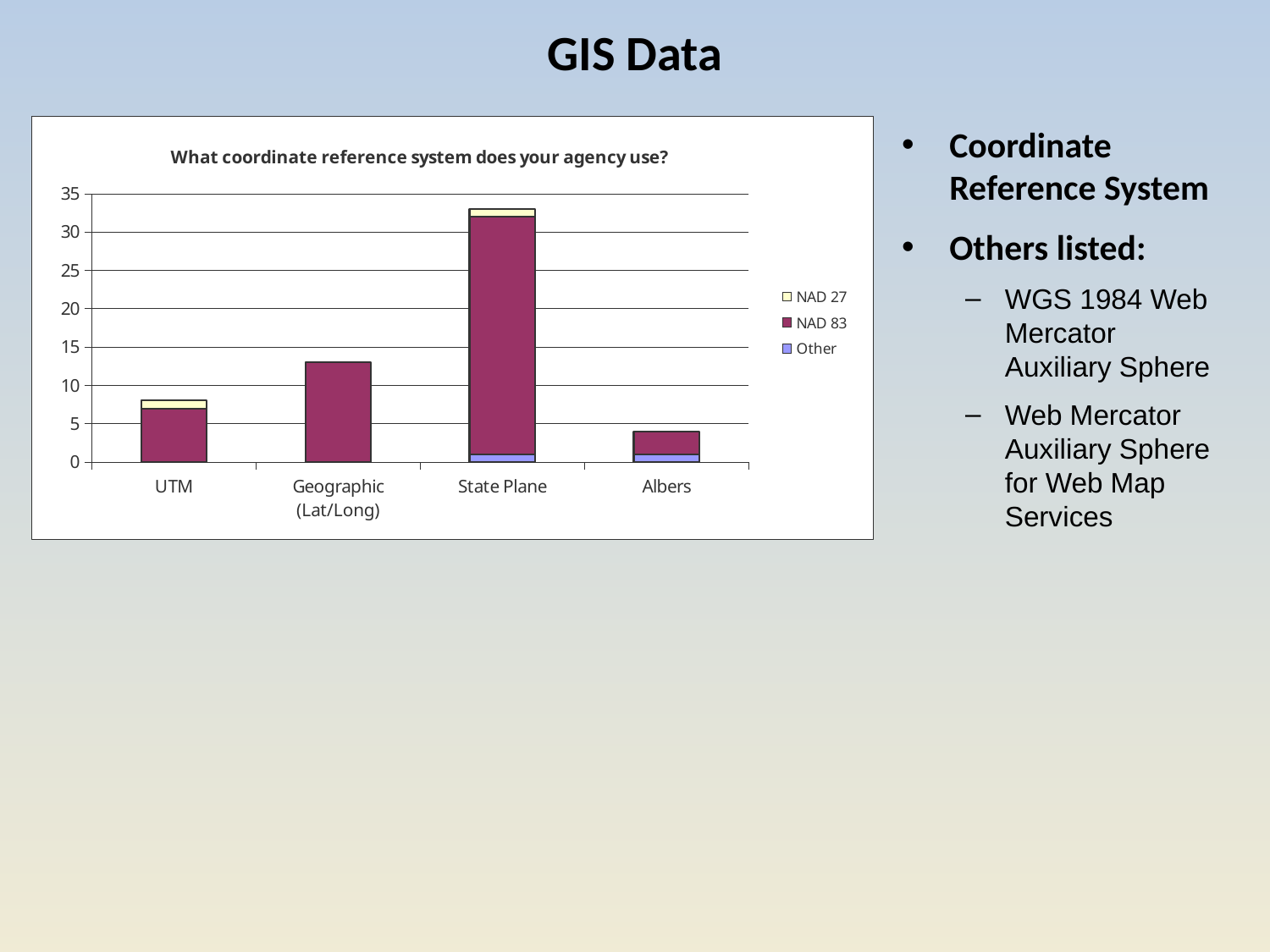
Is the total value for State Plane greater or less than 30? greater How many series does the legend list? 3 Is the total value for Albers greater or less than 10? less Which coordinate reference system has the shortest bar? Albers Which coordinate reference system has the tallest bar? State Plane Which series is shown in the dark magenta colour in the legend? NAD 83 What is the title of the chart? What coordinate reference system does your agency use? Is the total value for UTM greater or less than 10? less What kind of chart is shown on the slide? bar chart Which has a taller bar, UTM or Geographic (Lat/Long)? Geographic (Lat/Long) How many coordinate reference system categories are shown on the x axis? 4